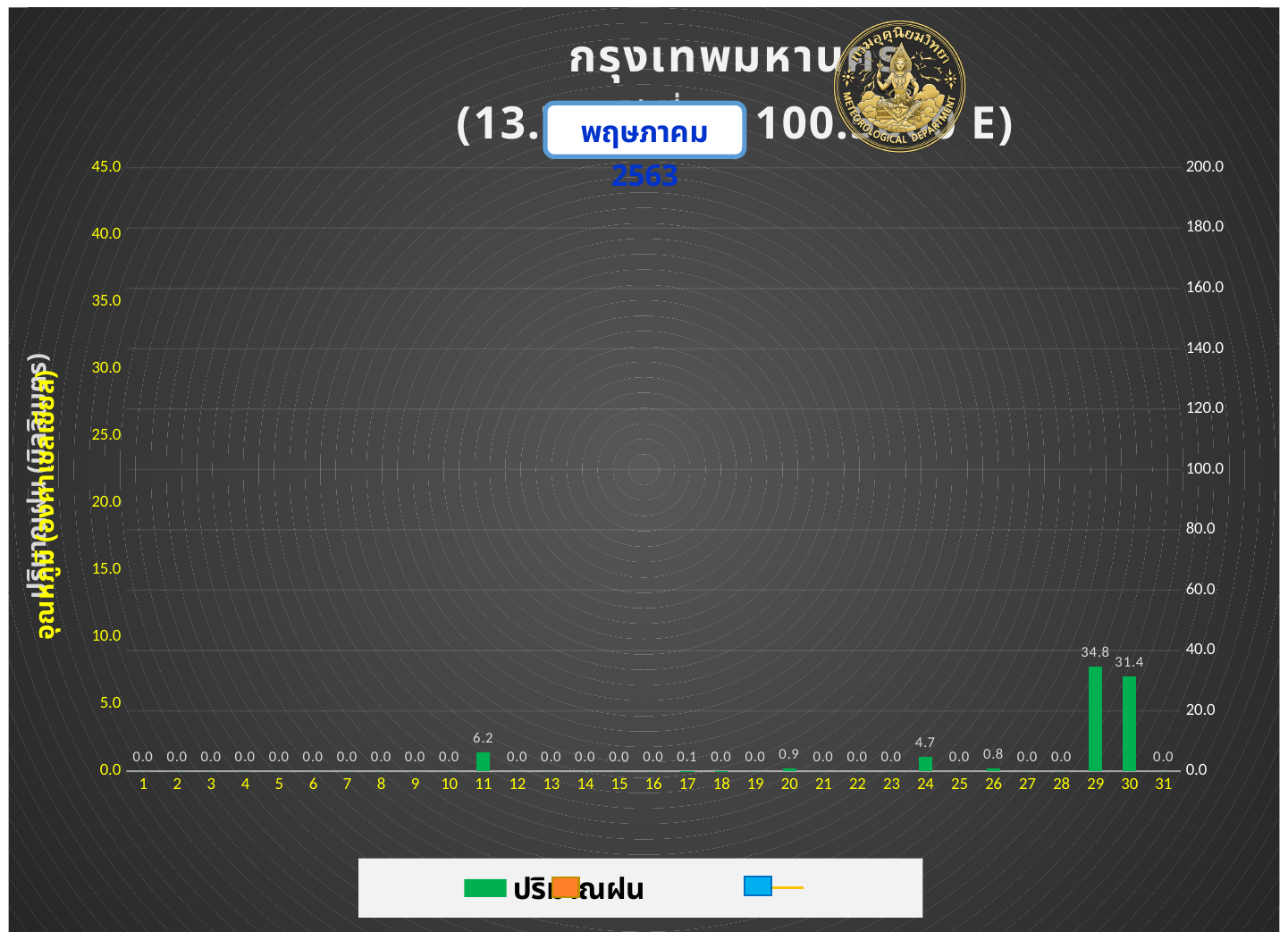
Which has a larger rainfall value, day 11 or day 24? day 11 What is the rainfall value for day 24? 4.7 What is the rainfall value for day 11? 6.2 Which has a larger rainfall value, day 20 or day 26? day 20 How many days are shown on the x axis? 31 What is the difference between the rainfall values for day 29 and day 30? 3.4 What kind of chart is shown on the slide? bar chart Which day has the highest rainfall value? 29 What is the rainfall value for day 16? 0.0 What is the rainfall value for day 29? 34.8 What is the rainfall value for day 30? 31.4 What is the total rainfall for days 29 and 30 combined? 66.2